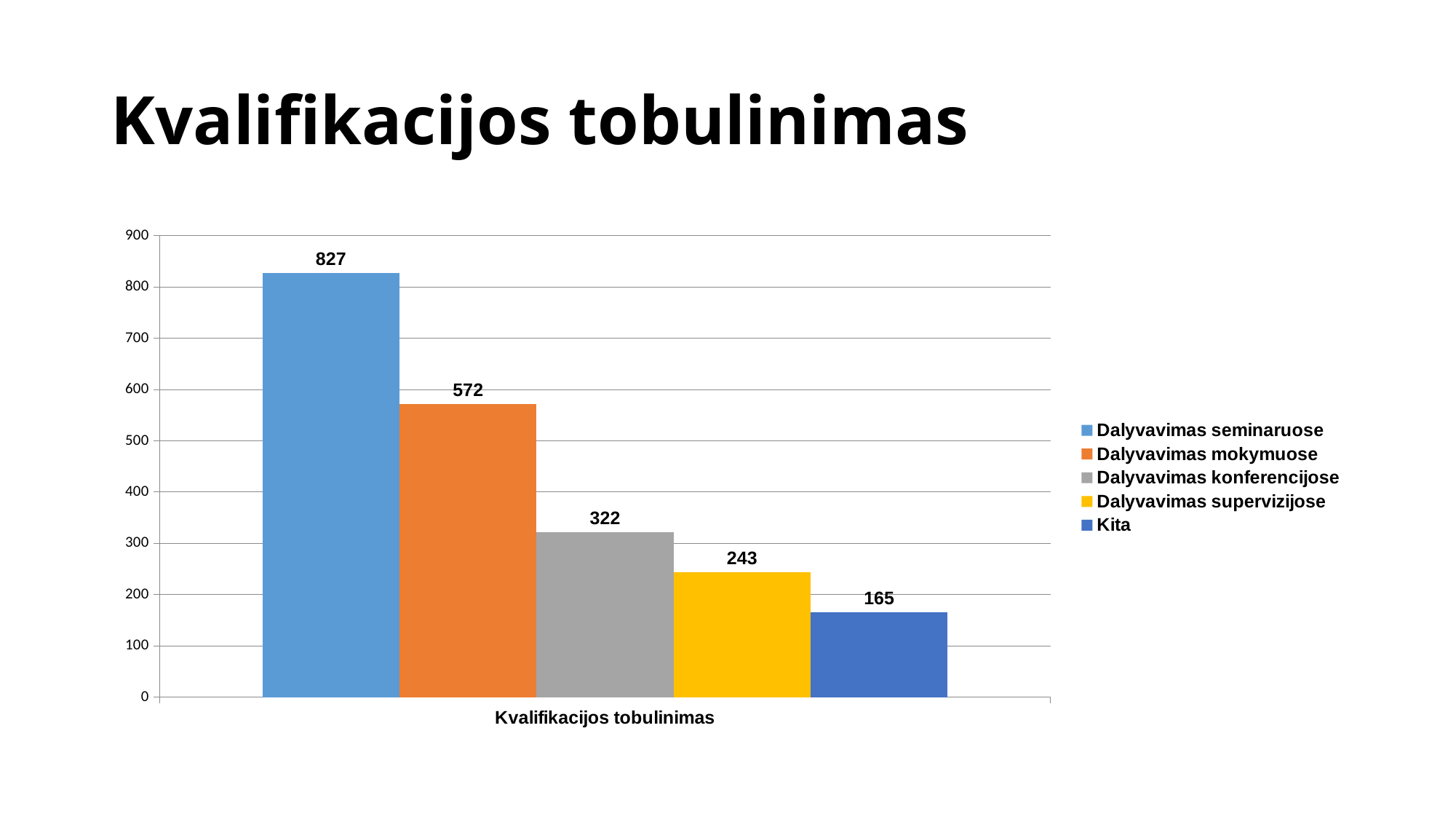
Which series has the highest value? Dalyvavimas seminaruose How many series does the legend list? 5 What is the difference between Dalyvavimas seminaruose and Dalyvavimas mokymuose? 255 What kind of chart is shown on the slide? Bar chart Which series has the lowest value? Kita What is the value for Dalyvavimas seminaruose? 827 What is the difference between Dalyvavimas supervizijose and Kita? 78 Which is larger, Dalyvavimas konferencijose or Dalyvavimas supervizijose? Dalyvavimas konferencijose What is the value for Dalyvavimas konferencijose? 322 What is the value for Dalyvavimas mokymuose? 572 What is the title of the slide? Kvalifikacijos tobulinimas What is the value for Kita? 165